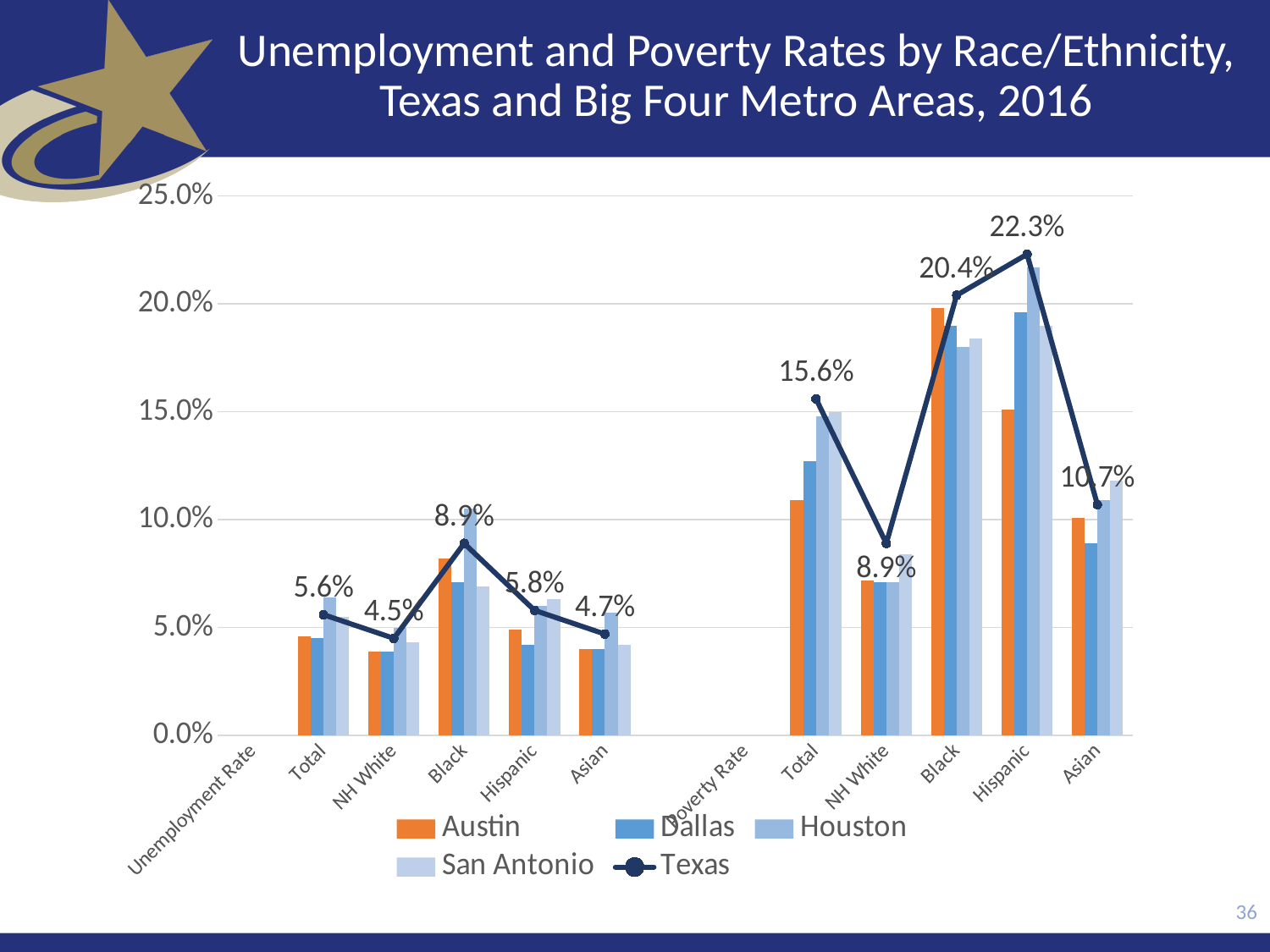
Which series is shown as a line rather than bars? Texas What is the Texas unemployment rate for Black residents? 8.9% Which race/ethnicity group has the lowest Texas unemployment rate? NH White What is the difference between the Texas poverty rate for Hispanic residents and for NH White residents? 13.4% Is the Austin poverty rate for Black residents greater or less than 15.0%? greater Is the Texas poverty rate for Black residents higher or lower than the Texas poverty rate for Asian residents? higher Which series is shown in orange? Austin What is the Texas poverty rate for Hispanic residents? 22.3% What is the Texas poverty rate for the Total category? 15.6% What is the Texas unemployment rate for NH White residents? 4.5% How many series does the legend list? 5 Which race/ethnicity group has the highest Texas poverty rate? Hispanic